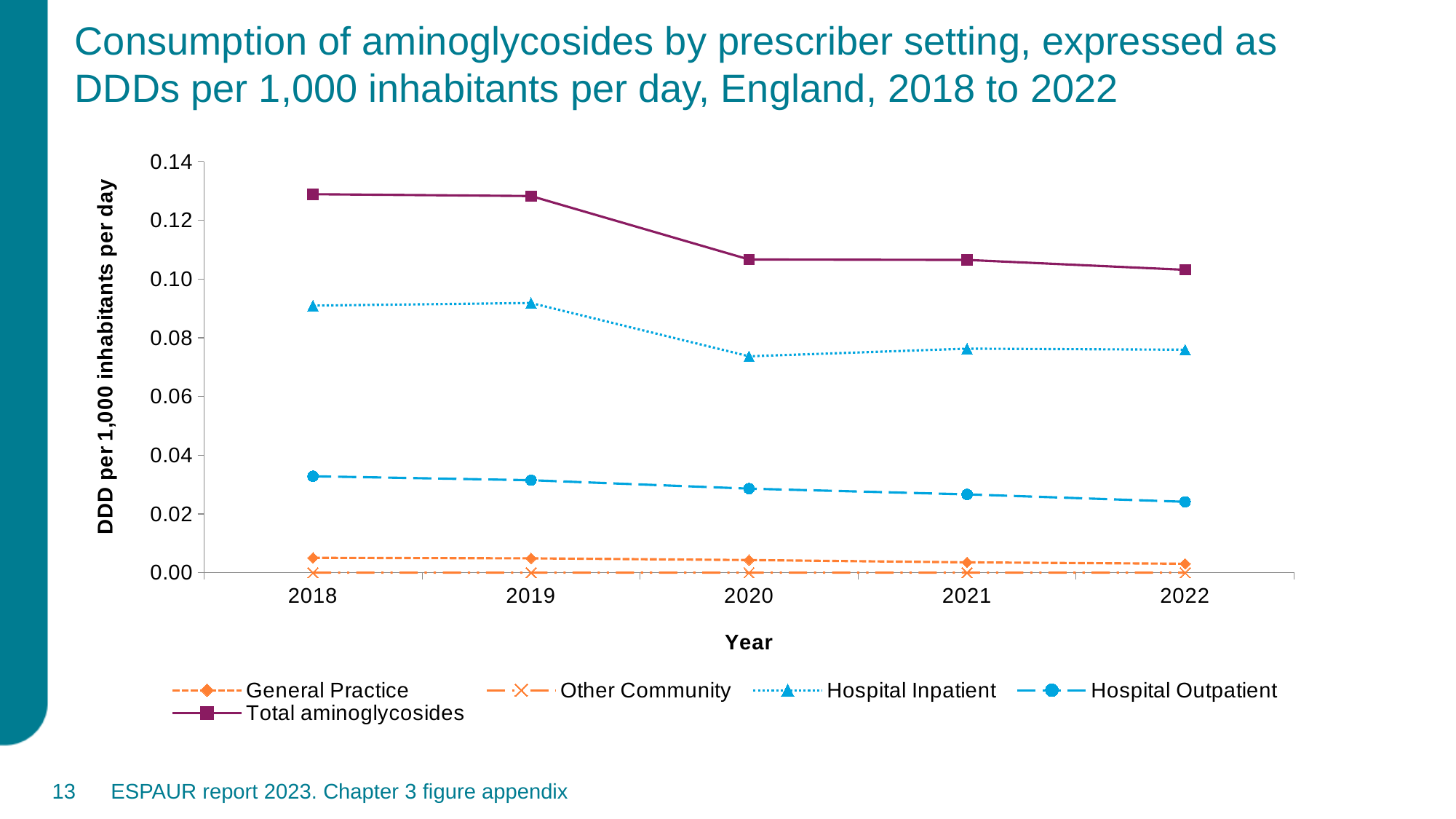
What kind of chart is shown on the slide? line chart How many years are plotted along the x axis? 5 How many series does the legend list? 5 Which series has the highest values across all years? Total aminoglycosides Which series has the lowest values across all years? Other Community Does the Total aminoglycosides series rise or fall from 2018 to 2022? fall Is the value for Total aminoglycosides in 2018 greater or less than 0.12? greater What is the label of the y axis? DDD per 1,000 inhabitants per day Which series is drawn with square markers? Total aminoglycosides Which is larger in 2021, Hospital Inpatient or Hospital Outpatient? Hospital Inpatient Is the value for Hospital Inpatient in 2020 greater or less than 0.08? less Is the value for Hospital Outpatient in 2022 greater or less than 0.02? greater